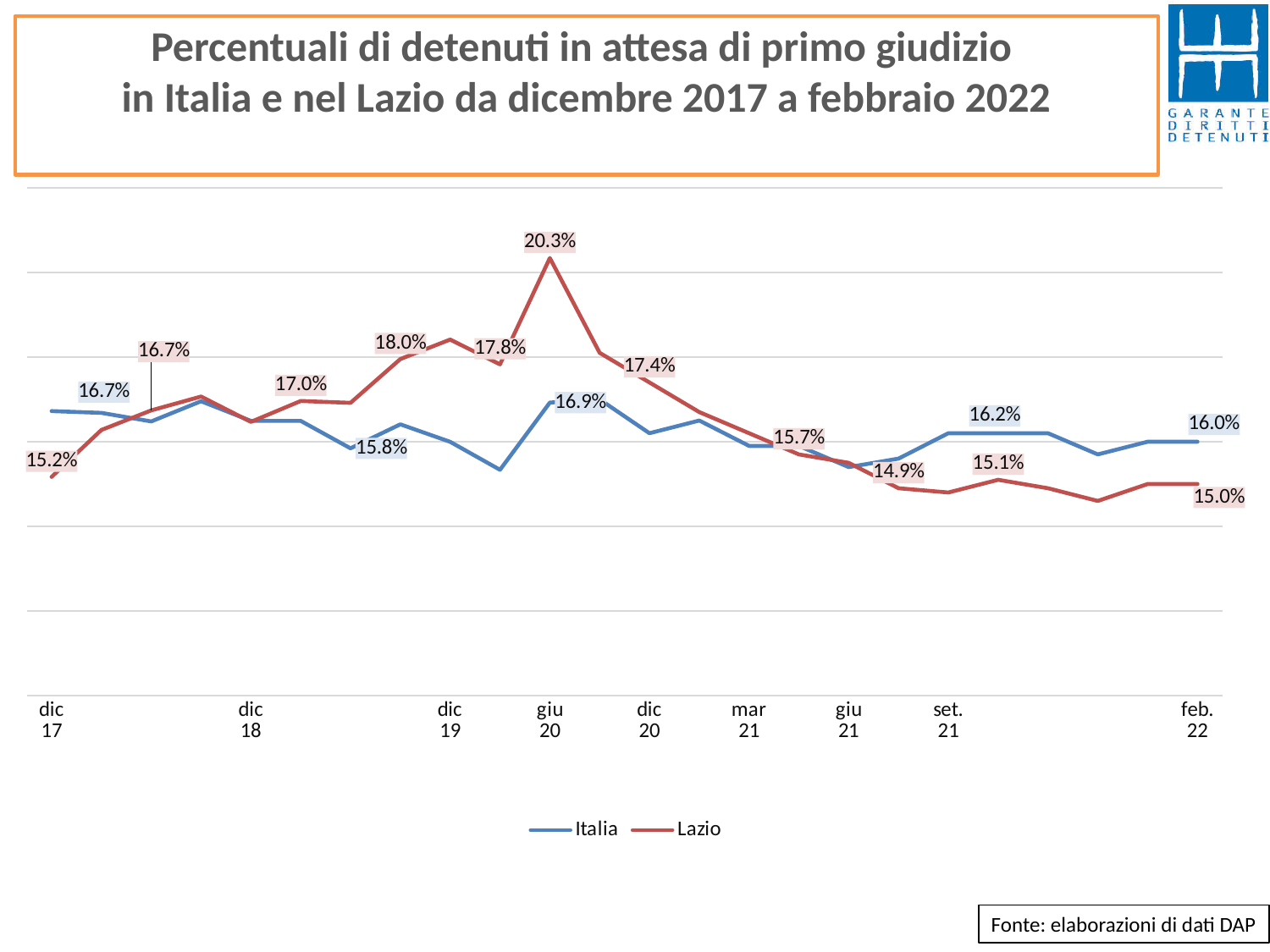
What are the two series named in the legend? Italia and Lazio What is the value for Lazio at giu 20? 20.3% What is the difference between the Lazio and Italia values at giu 20? 3.4 percentage points What is the value for Italia at feb. 22? 16.0% Does the Lazio line rise or fall from giu 20 to feb. 22? Fall Which series has the higher value at feb. 22, Italia or Lazio? Italia What is the value for Lazio at feb. 22? 15.0% At which point on the x axis does the Lazio line reach its highest value? giu 20 What is the value for Lazio at dic 17? 15.2% What kind of chart is shown on the slide? Line chart What is the value for Italia at giu 20? 16.9% How many series does the legend list? 2